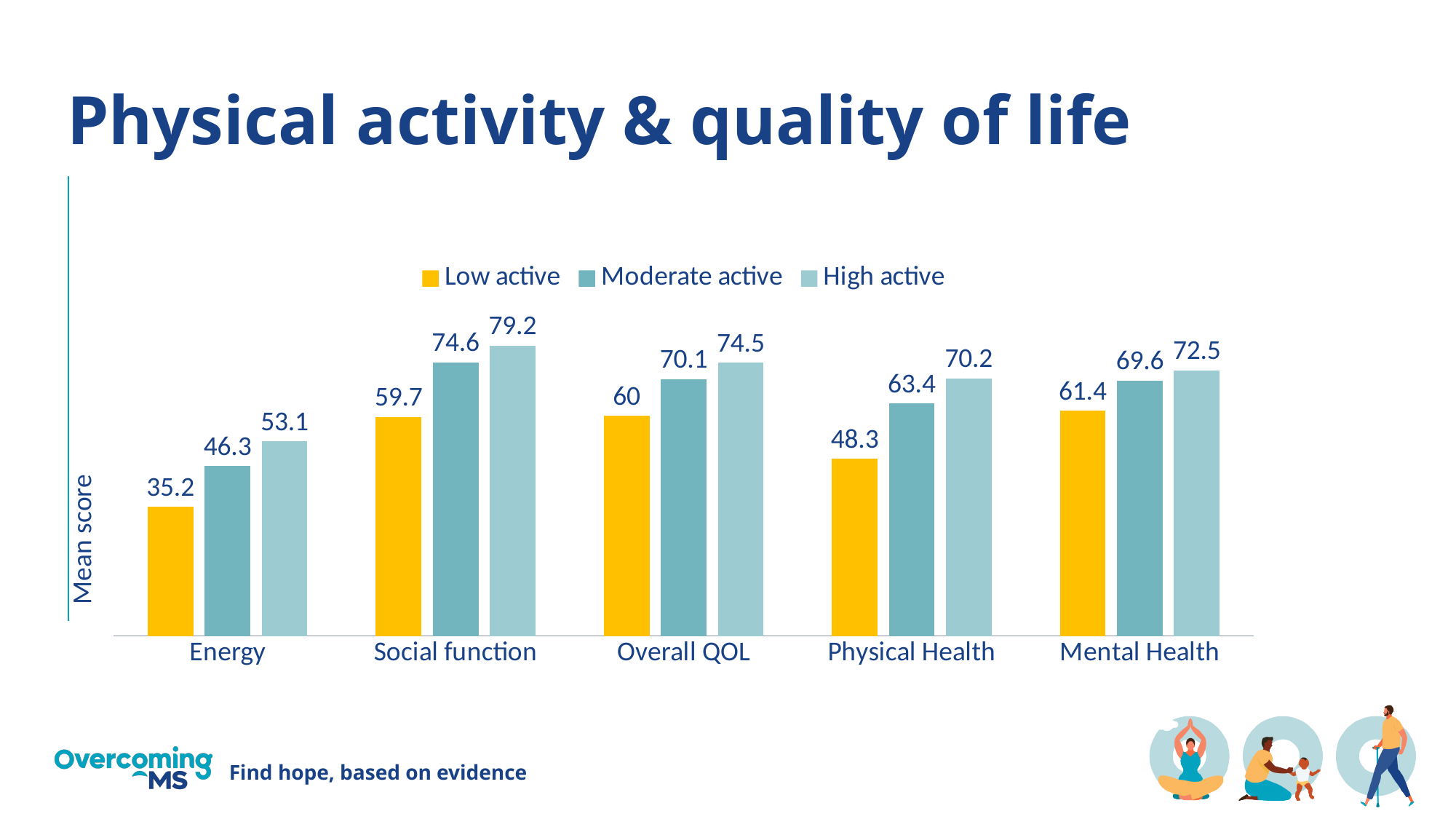
Which is larger: the Moderate active score for Mental Health or the Moderate active score for Overall QOL? Overall QOL What is the mean score for the Moderate active group on Physical Health? 63.4 What type of chart is shown on the slide? Bar chart What is the mean score for the High active group on Social function? 79.2 What is the difference between the Moderate active and Low active mean scores for Physical Health? 15.1 Which category has the highest High active mean score? Social function How many series does the legend list? 3 What is the mean score for the Low active group on Overall QOL? 60 How many categories are shown on the x axis? 5 What is the difference between the High active and Low active mean scores for Energy? 17.9 What is the mean score for the Low active group on Energy? 35.2 Which category has the lowest Low active mean score? Energy